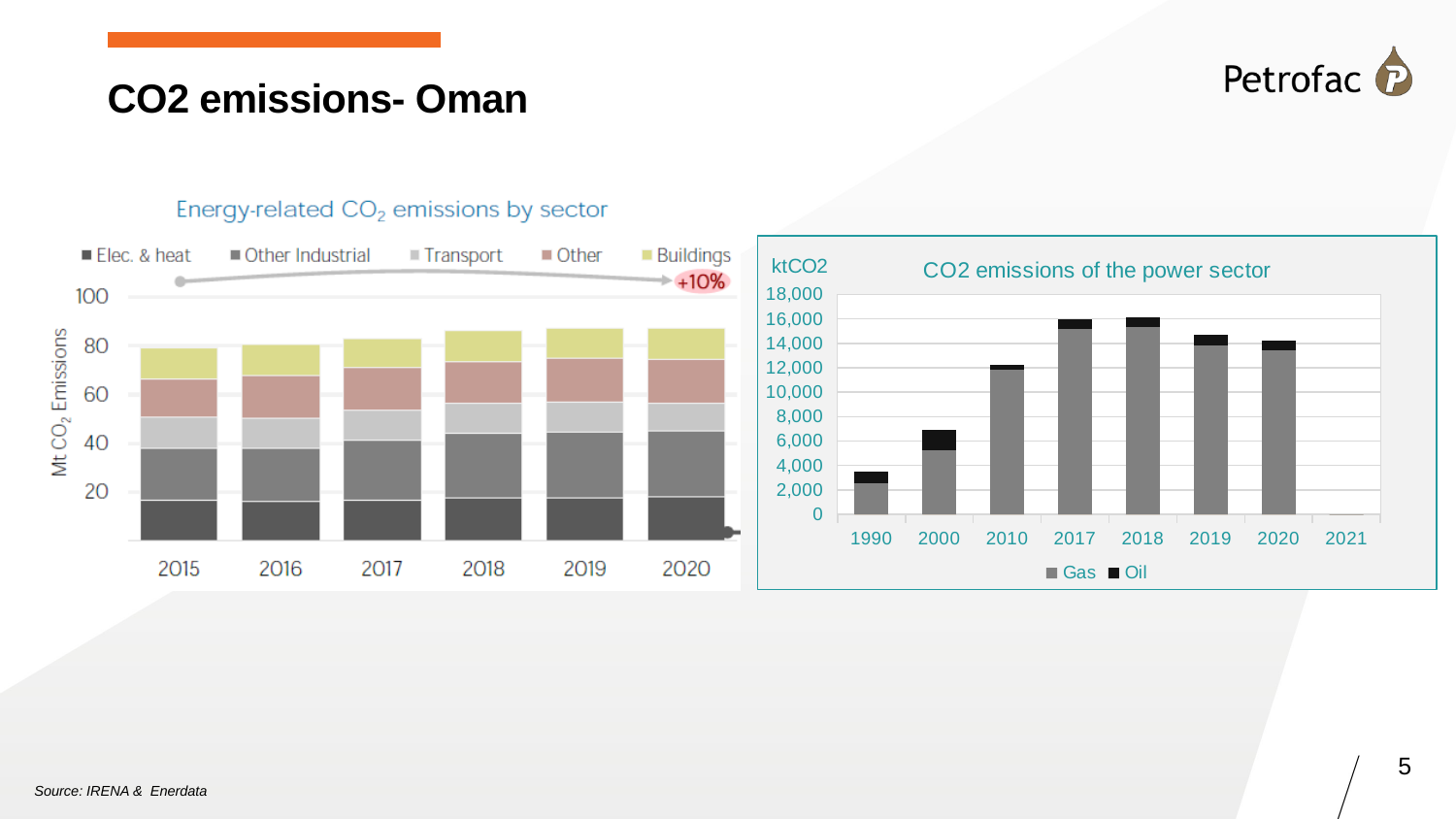
In the 'CO2 emissions of the power sector' chart, what unit is shown above the y axis? ktCO2 How many series does the legend of the 'CO2 emissions of the power sector' chart list? 2 In the 'CO2 emissions of the power sector' chart, which year has the larger total, 2000 or 2010? 2010 How many years are shown on the x axis of the 'CO2 emissions of the power sector' chart? 8 What kind of chart is the 'CO2 emissions of the power sector' chart? Stacked bar chart In the 'Energy-related CO2 emissions by sector' chart, do total emissions rise or fall from 2015 to 2020? rise How many series does the legend of the 'Energy-related CO2 emissions by sector' chart list? 5 How many years are shown on the x axis of the 'Energy-related CO2 emissions by sector' chart? 6 In the 'Energy-related CO2 emissions by sector' chart, is the total for 2020 greater or less than 80? greater In the 'CO2 emissions of the power sector' chart, is the total for 1990 greater or less than 4,000? less In the 'CO2 emissions of the power sector' chart, is the total for 2010 greater or less than 10,000? greater In the 'CO2 emissions of the power sector' chart, which year has the larger total, 2017 or 2019? 2017